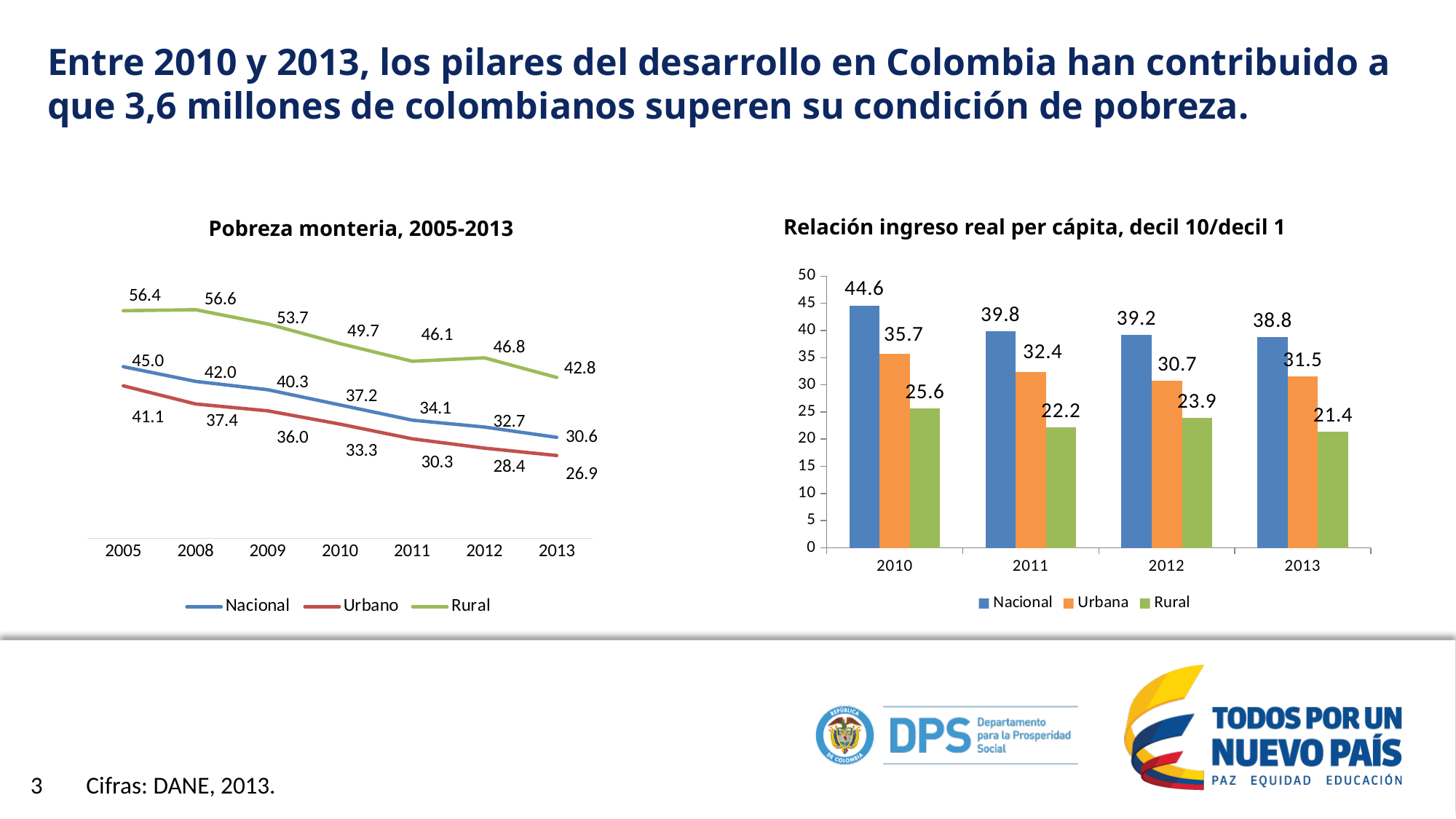
In the 'Pobreza monteria, 2005-2013' chart, what is the Nacional value for 2013? 30.6 In the 'Relación ingreso real per cápita, decil 10/decil 1' chart, what is the difference between the Nacional values for 2010 and 2013? 5.8 What kind of chart is 'Pobreza monteria, 2005-2013'? line chart In the 'Pobreza monteria, 2005-2013' chart, what is the Rural value for 2010? 49.7 In the 'Pobreza monteria, 2005-2013' chart, in which year is the Rural series highest? 2008 In the 'Relación ingreso real per cápita, decil 10/decil 1' chart, what is the Urbana value for 2012? 30.7 In the 'Pobreza monteria, 2005-2013' chart, what is the Urbano value for 2009? 36.0 In the 'Pobreza monteria, 2005-2013' chart, what is the difference between the Rural and Urbano values in 2013? 15.9 In the 'Pobreza monteria, 2005-2013' chart, does the Nacional series rise or fall from 2005 to 2013? fall In the 'Relación ingreso real per cápita, decil 10/decil 1' chart, which year has the lowest Rural value? 2013 In the 'Pobreza monteria, 2005-2013' chart, how many years are shown on the x axis? 7 How many series does the legend of the 'Relación ingreso real per cápita, decil 10/decil 1' chart list? 3